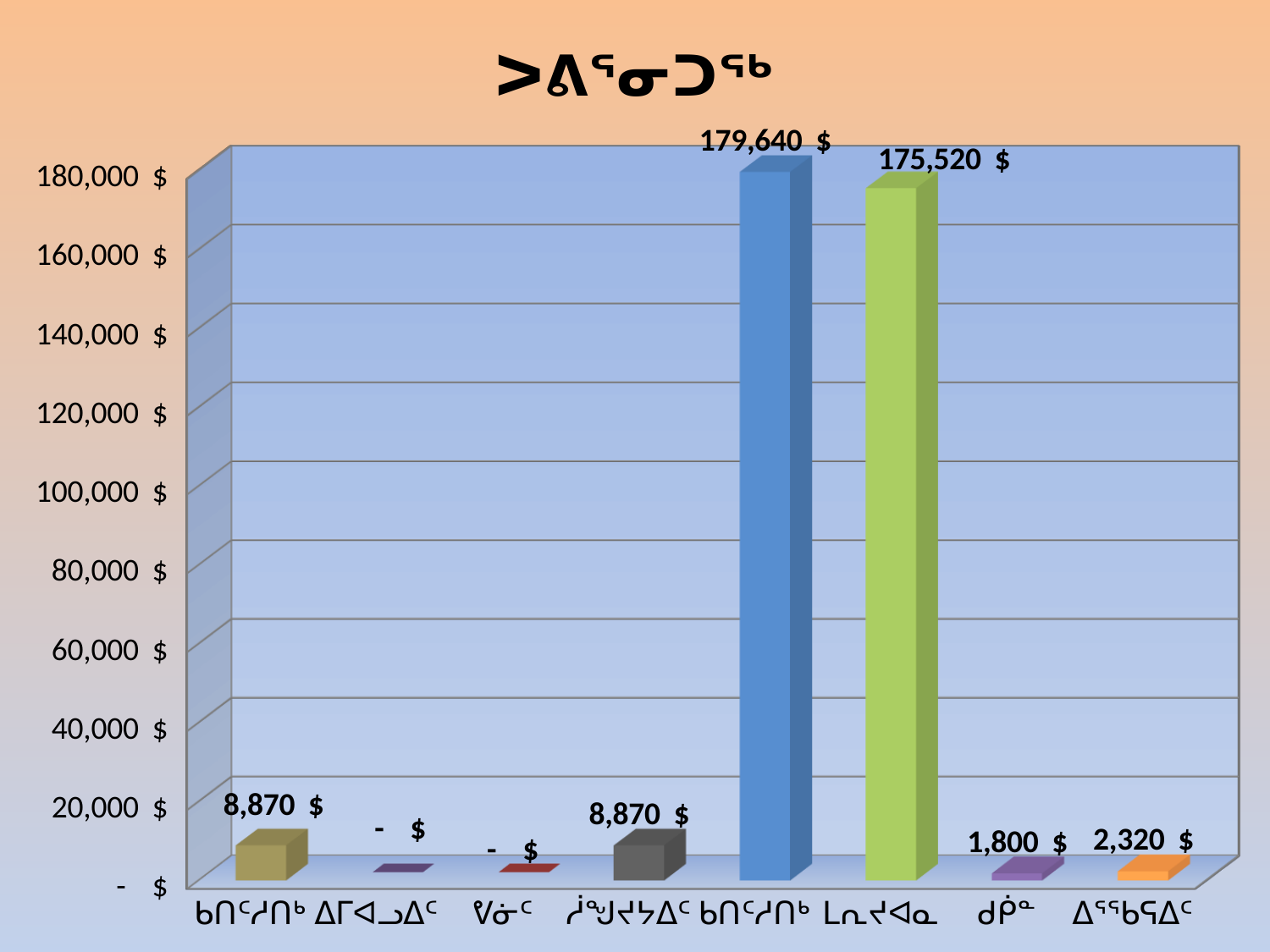
What colour is the tallest bar? blue How many categories are plotted along the x axis? 8 What kind of chart is shown on the slide? bar chart What is the value shown on the last bar on the right? 2,320 $ Which bar has the highest value? the fifth bar from the left (179,640 $) What is the value shown on the sixth bar from the left? 175,520 $ What is the value shown on the fifth bar from the left? 179,640 $ What is the value shown on the seventh bar from the left? 1,800 $ What is the value shown on the first bar from the left? 8,870 $ How many bars are labelled with a dash ("- $"), indicating no value? 2 What is the difference between the fifth bar (179,640 $) and the sixth bar (175,520 $)? 4,120 $ Which is larger, the seventh bar (1,800 $) or the eighth bar (2,320 $)? the eighth bar (2,320 $)